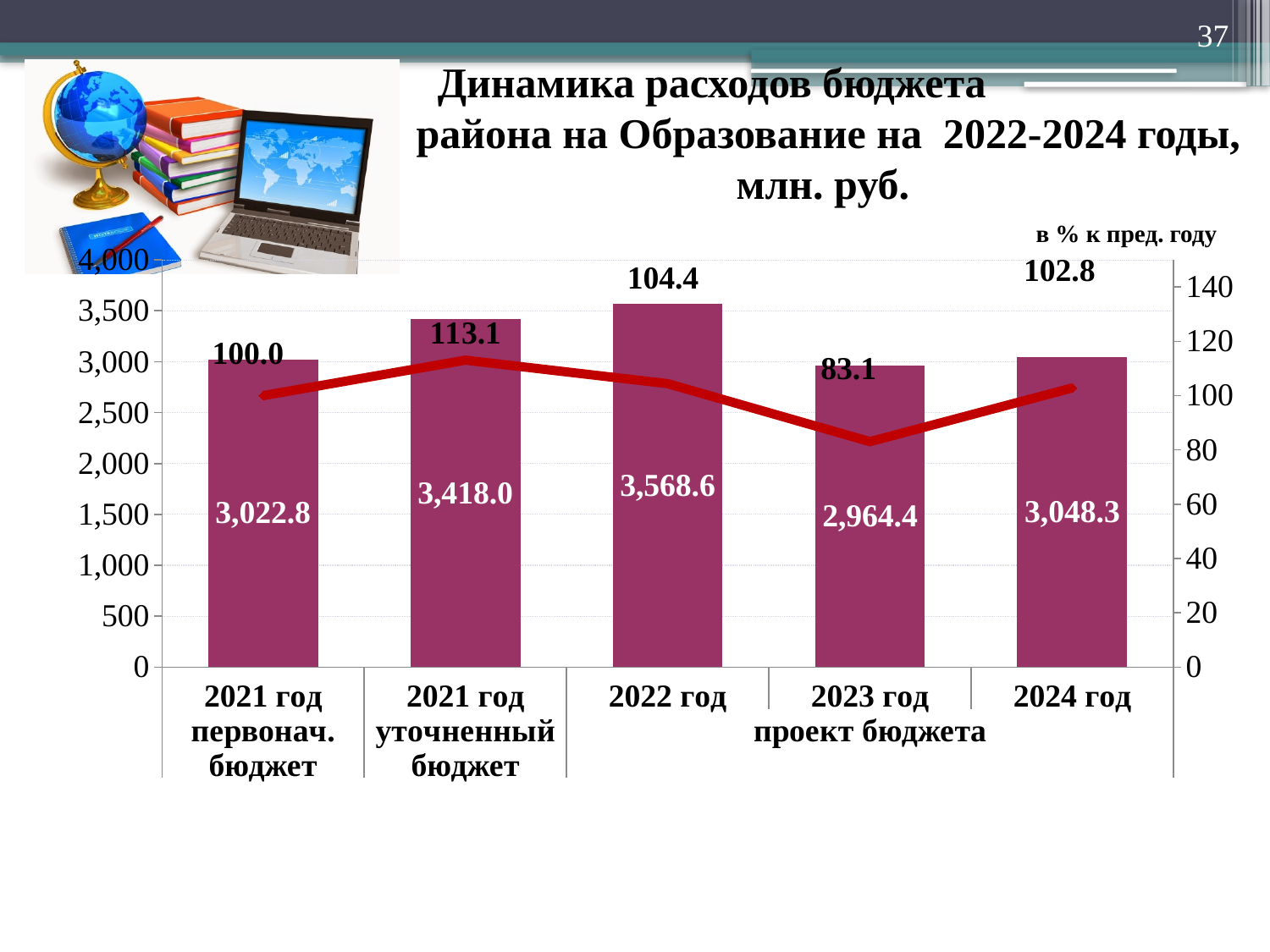
Which is larger, the bar value for 2024 год or for 2021 год первонач. бюджет? 2024 год What percentage to the previous year is shown for 2024 год? 102.8 Does the line of percentages to the previous year rise or fall from 2022 год to 2023 год? Fall What is the title of the chart? Динамика расходов бюджета района на Образование на 2022-2024 годы, млн. руб. What kind of chart is shown on the slide? Combined bar and line chart What percentage to the previous year is shown for 2023 год? 83.1 Which category has the highest bar value? 2022 год What is the budget expenditure value shown for 2022 год? 3,568.6 What is the difference between the bar values for 2022 год and 2023 год? 604.2 How many categories are shown on the x axis? 5 What is the bar value for 2021 год уточненный бюджет? 3,418.0 Which category has the lowest bar value? 2023 год